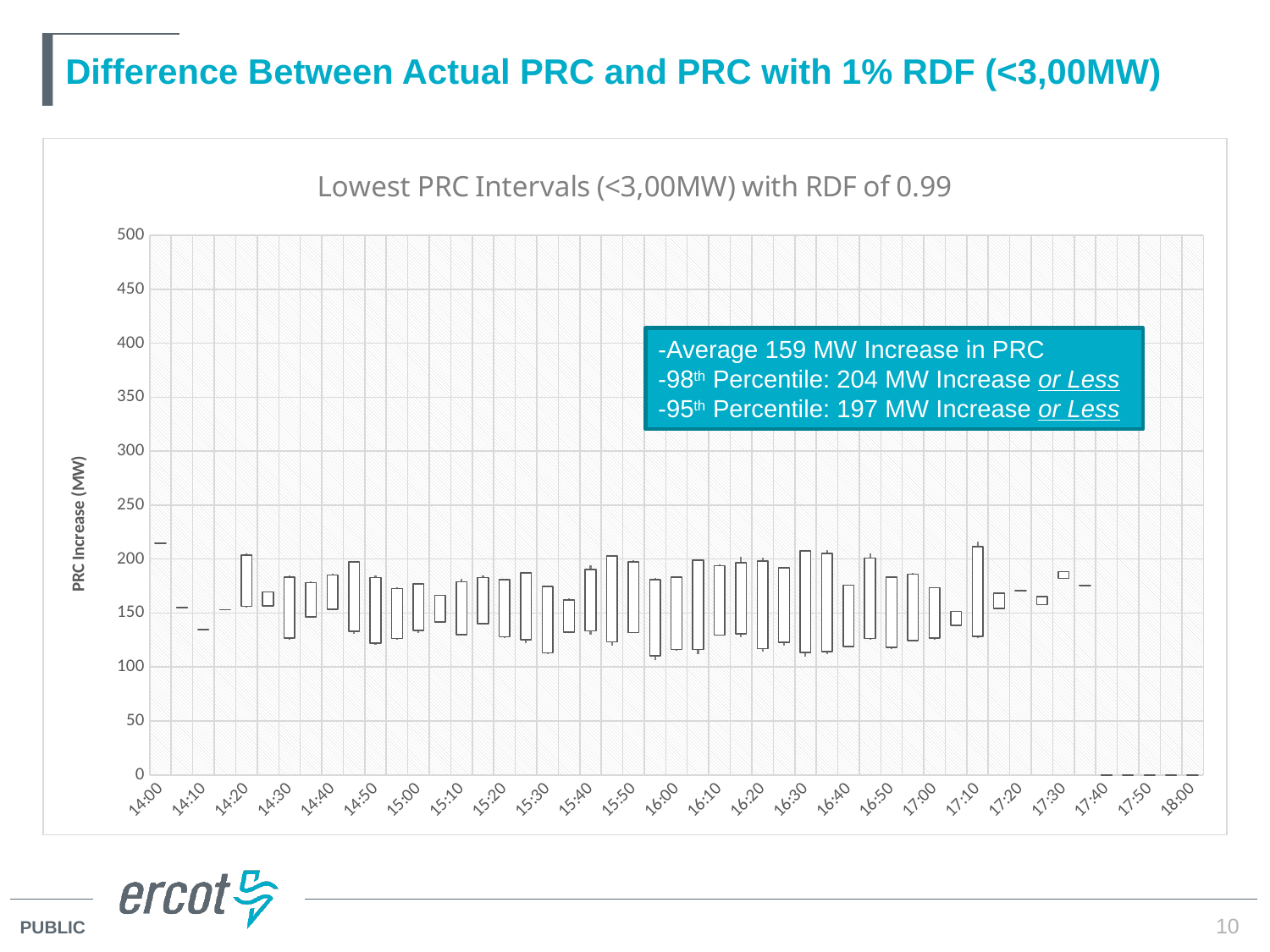
Is the value plotted at 17:40 greater or less than 50? less What is the label of the vertical axis? PRC Increase (MW) Is the value plotted at 14:10 greater or less than 150? less According to the annotation on the chart, what is the 95th percentile MW increase? 197 MW According to the annotation on the chart, what is the 98th percentile MW increase? 204 MW Is the top of the bar at 17:10 greater or less than 200? greater Which is larger, the 98th percentile increase or the 95th percentile increase shown in the annotation? 98th percentile What kind of chart is shown on the slide? stock (candlestick) chart According to the annotation on the chart, what is the average MW increase in PRC? 159 MW What is the title of the chart? Lowest PRC Intervals (<3,00MW) with RDF of 0.99